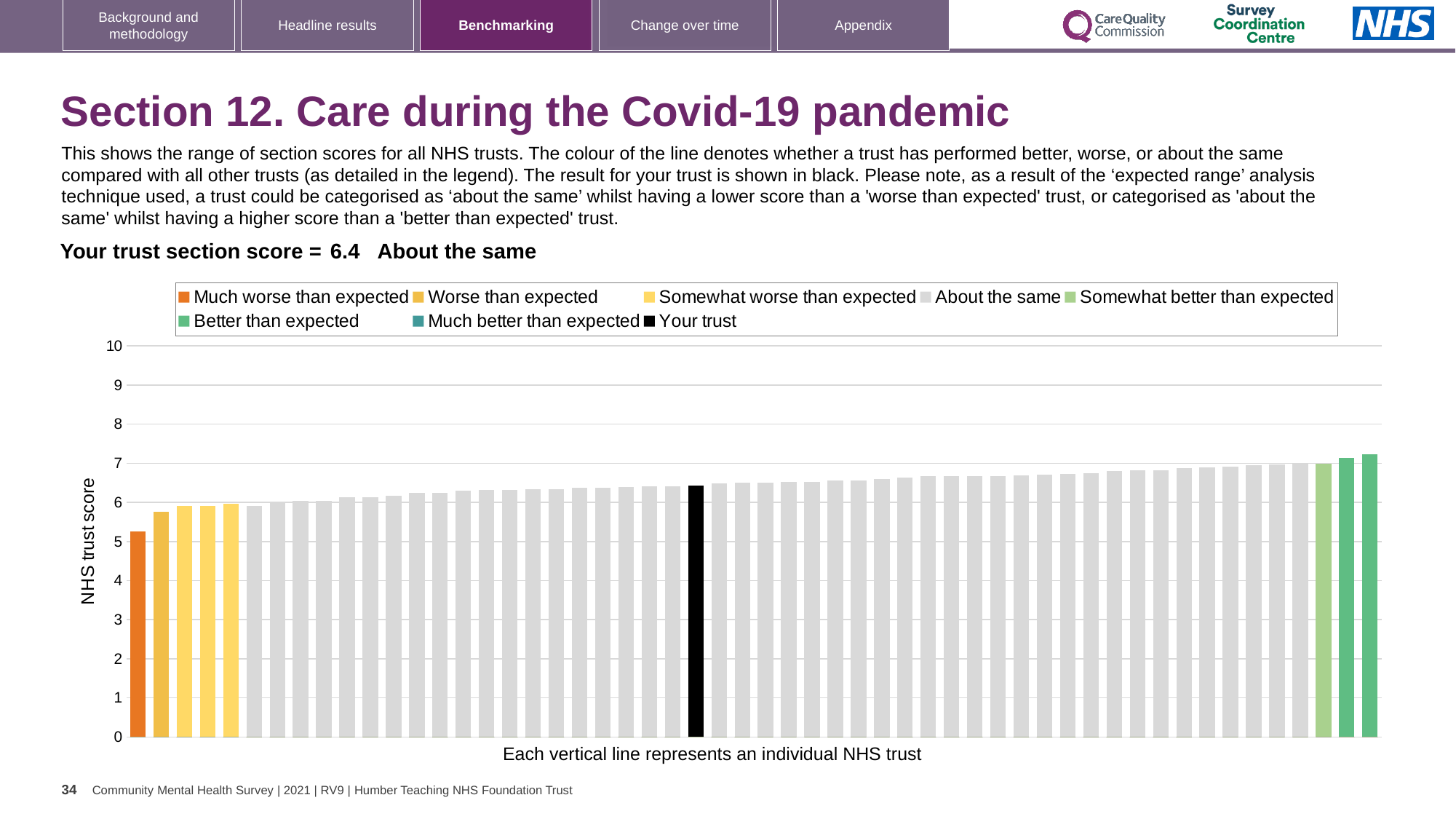
Is the value for the leftmost (orange) bar greater or less than 6? less How many entries does the chart legend list? 8 Is the value for your trust (black bar) greater or less than 6? greater How many bars are coloured orange (Much worse than expected)? 1 Which legend category does the lowest bar on the chart belong to? Much worse than expected What is the section score for your trust shown on the slide? 6.4 How is your trust's performance categorised on the slide? About the same Which is larger: the value for your trust (black bar) or the value for the leftmost orange bar? your trust Is the value for the rightmost bar greater or less than 7? greater What kind of chart is shown on the slide? bar chart What is the label on the y axis of the chart? NHS trust score Do the bar values rise or fall from left to right along the x axis? rise